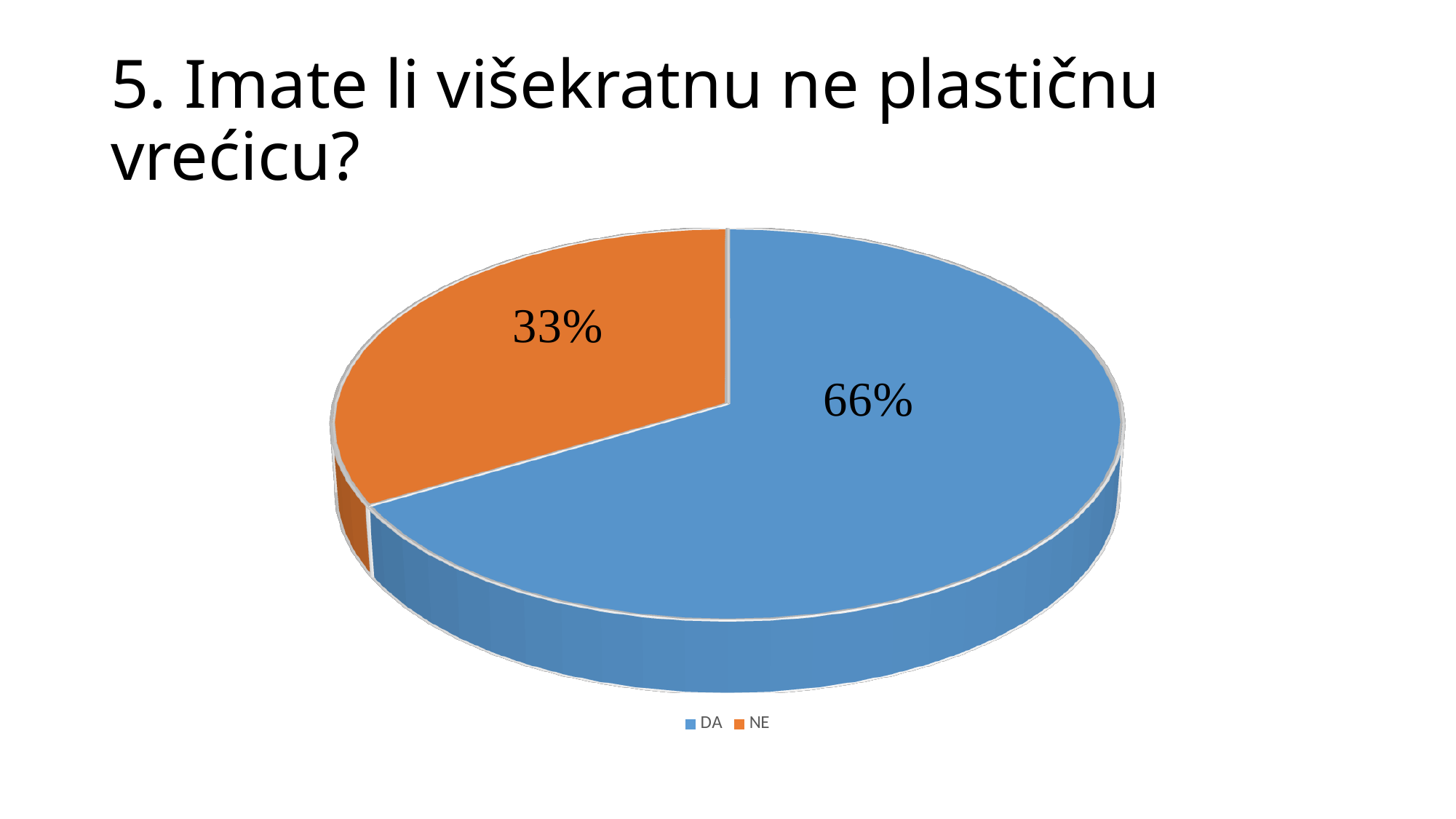
What colour is the DA slice? Blue How many entries does the legend list? 2 Is the share for DA greater or less than 50%? greater How many slices does the pie chart have? 2 What kind of chart is shown on the slide? Pie chart Which slice is larger, DA or NE? DA What is the difference in percentage points between the DA and NE slices? 33 Which slice is the largest in the pie chart? DA What share of the pie does the NE slice represent? 33% Which slice is the smallest in the pie chart? NE What share of the pie does the DA slice represent? 66% What is the title of the slide above the chart? 5. Imate li višekratnu ne plastičnu vrećicu?